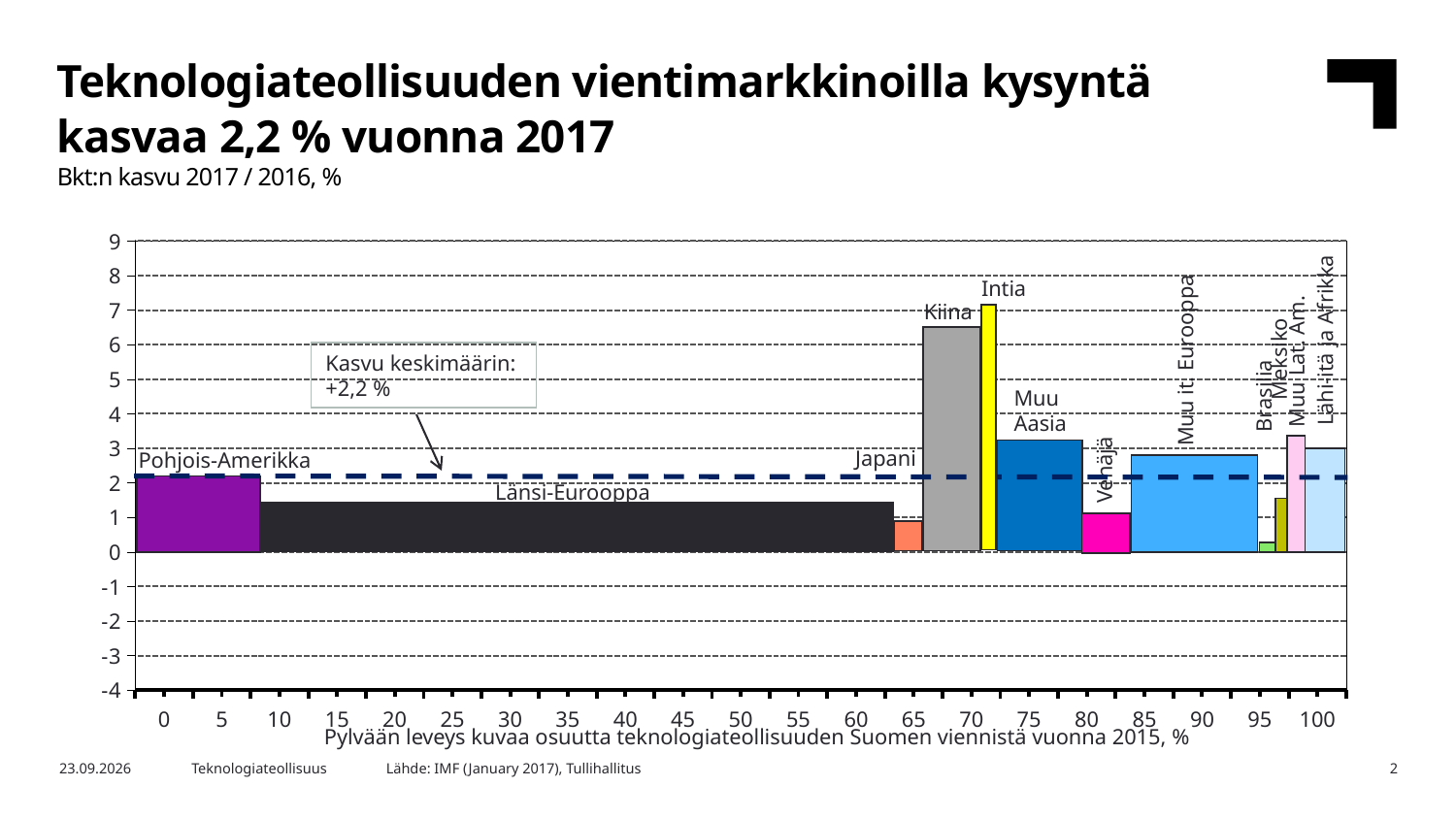
Which region has the highest GDP growth bar on the chart? Intia According to the x-axis caption, what does the width of each bar represent? Osuutta teknologiateollisuuden Suomen viennistä vuonna 2015, % What kind of chart is shown on the slide? bar chart Is the value for Länsi-Eurooppa greater or less than 2? less Which has the larger value, Kiina or Muu Aasia? Kiina Is the value for Muu Aasia greater or less than 3? greater Which has the larger value, Pohjois-Amerikka or Länsi-Eurooppa? Pohjois-Amerikka Is the value for Venäjä greater or less than 2? less What average growth value is printed in the annotation box on the chart? +2,2 % Which region has the lowest GDP growth bar on the chart? Brasilia